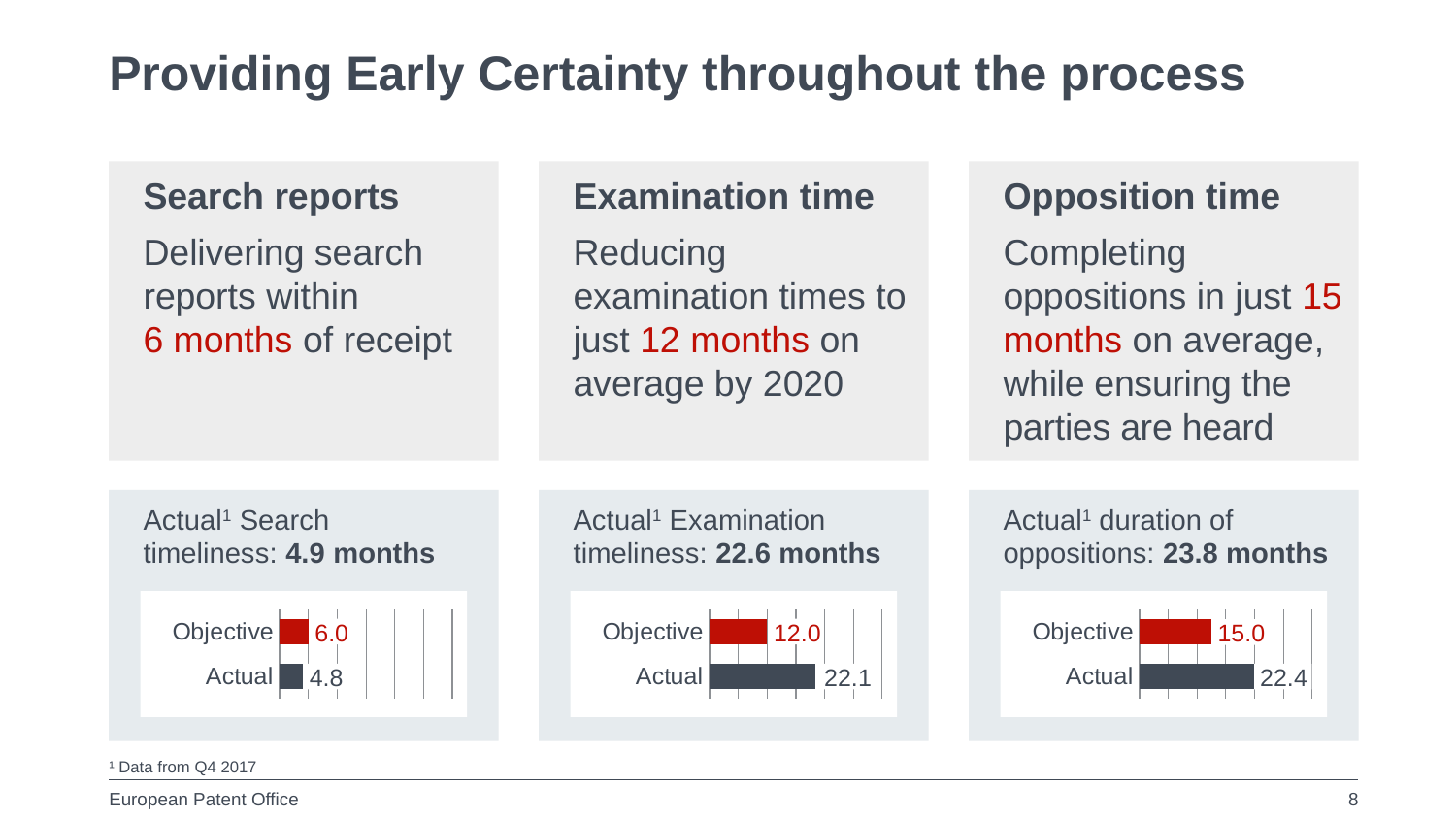
What kind of chart is used in the three panels at the bottom of the slide? Bar chart In the right chart (Opposition time), what is the value of the Objective bar? 15.0 In the left chart (Search reports), what is the value of the Actual bar? 4.8 How many bars does the right chart (Opposition time) show? 2 In the middle chart (Examination time), what is the difference between the Actual and Objective values? 10.1 In the middle chart (Examination time), what is the value of the Actual bar? 22.1 In the left chart (Search reports), which bar is longer, Objective or Actual? Objective In the right chart (Opposition time), what is the value of the Actual bar? 22.4 In the middle chart (Examination time), what is the value of the Objective bar? 12.0 In the left chart (Search reports), what is the value of the Objective bar? 6.0 In the middle chart (Examination time), which bar is longer, Objective or Actual? Actual In the right chart (Opposition time), what is the difference between the Actual and Objective values? 7.4